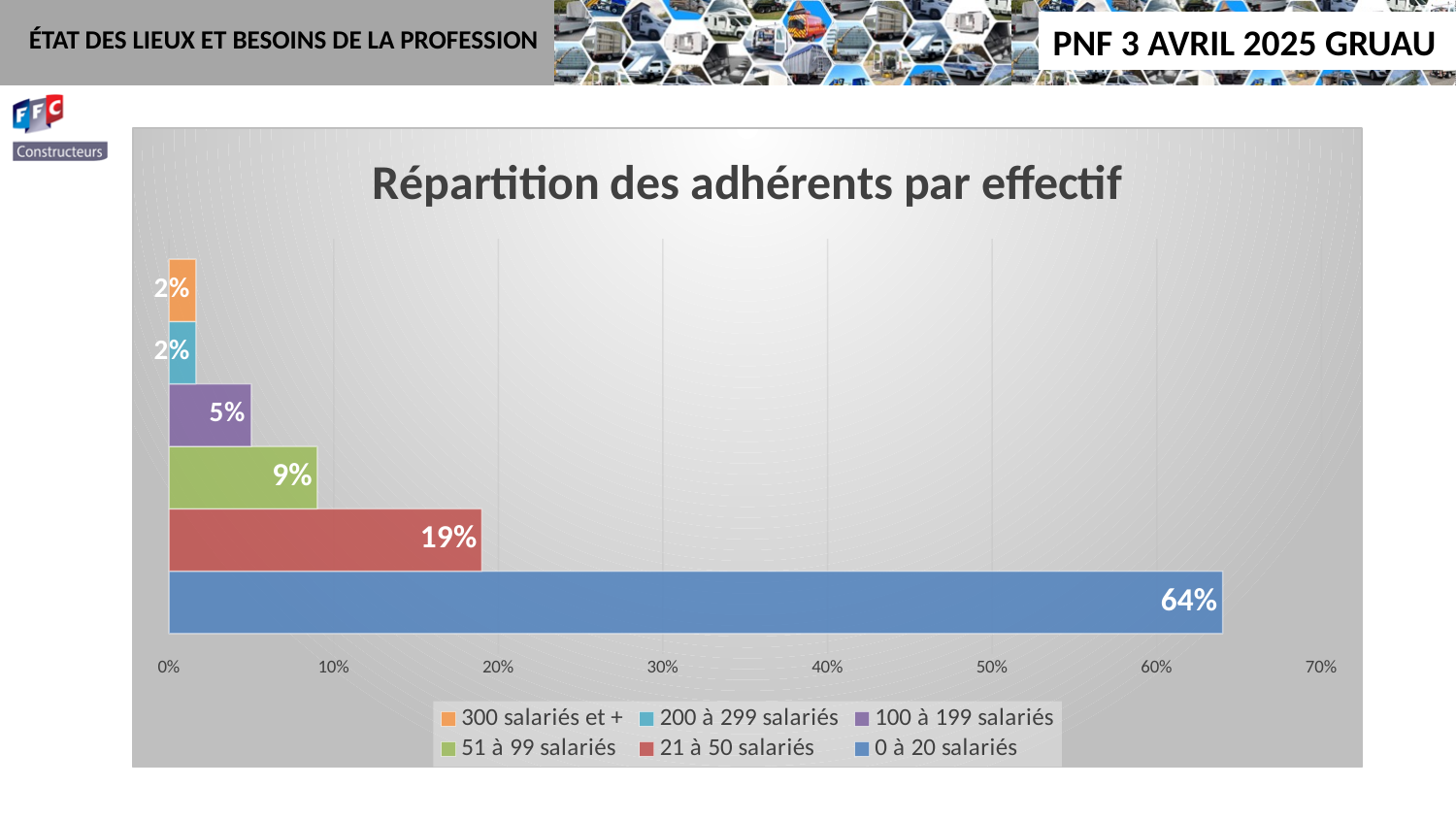
What is the value for 0 à 20 salariés? 64% Is the value for 0 à 20 salariés greater or less than 60%? greater Which is larger, the value for 21 à 50 salariés or the value for 51 à 99 salariés? 21 à 50 salariés What is the value for 100 à 199 salariés? 5% What kind of chart is shown? bar chart What is the value for 21 à 50 salariés? 19% What is the title of the chart? Répartition des adhérents par effectif What is the difference between the values for 51 à 99 salariés and 100 à 199 salariés? 4% What is the value for 51 à 99 salariés? 9% Which category has the highest value? 0 à 20 salariés How many series does the legend list? 6 What is the difference between the values for 0 à 20 salariés and 21 à 50 salariés? 45%